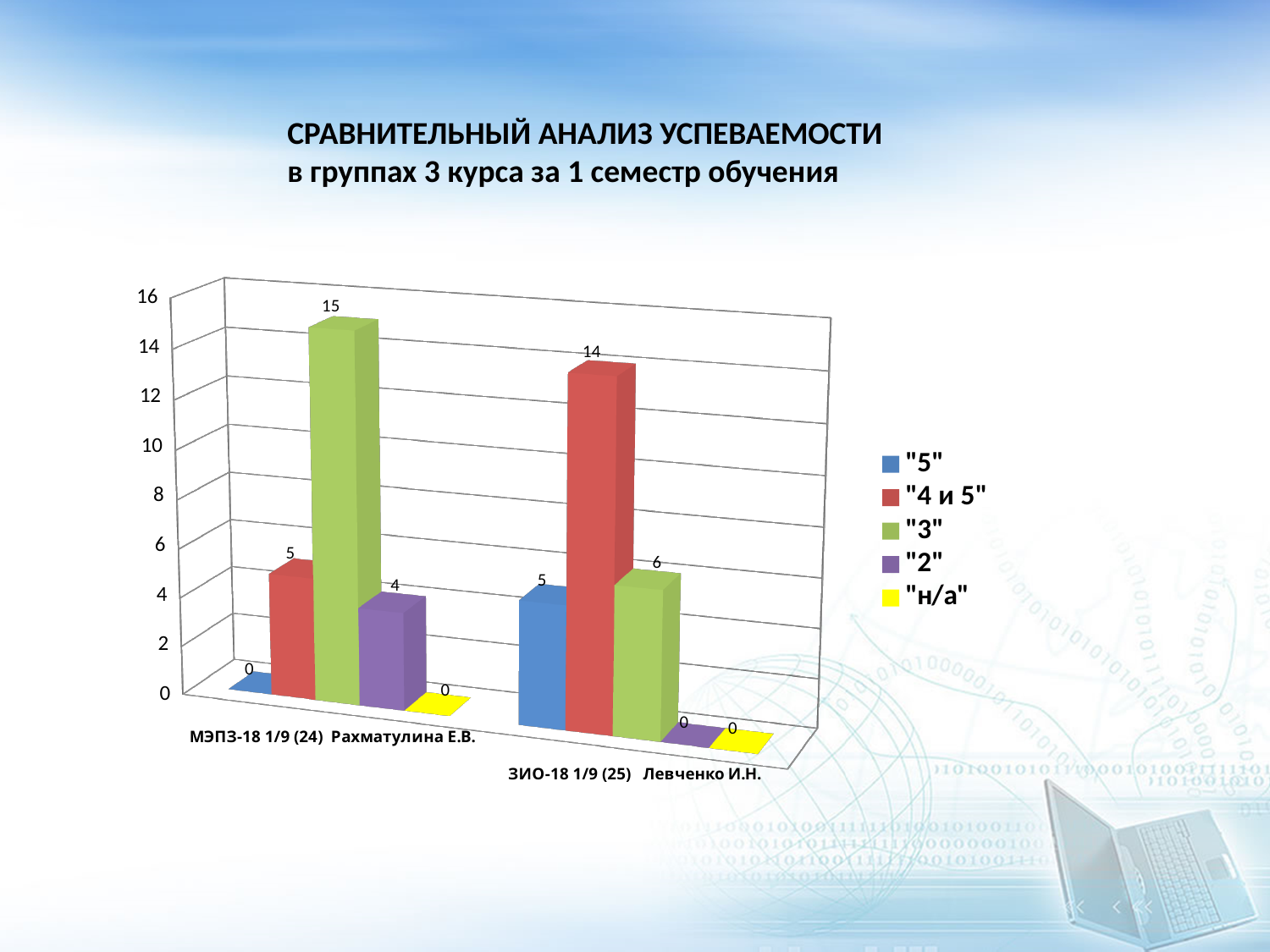
What colour represents the "н/а" series in the legend? yellow How many groups (categories) are shown on the x axis? 2 What is the difference between the "3" values for МЭПЗ-18 1/9 (24) and ЗИО-18 1/9 (25)? 9 What is the value of "2" for МЭПЗ-18 1/9 (24) Рахматулина Е.В.? 4 What type of chart is shown on the slide? bar chart What is the value of "5" for ЗИО-18 1/9 (25) Левченко И.Н.? 5 Which group has the larger value for "5": МЭПЗ-18 1/9 (24) or ЗИО-18 1/9 (25)? ЗИО-18 1/9 (25) Which series has the highest value for МЭПЗ-18 1/9 (24) Рахматулина Е.В.? "3" What is the value of "4 и 5" for ЗИО-18 1/9 (25) Левченко И.Н.? 14 How many series does the legend list? 5 What is the value of "3" for МЭПЗ-18 1/9 (24) Рахматулина Е.В.? 15 Which series has the highest value for ЗИО-18 1/9 (25) Левченко И.Н.? "4 и 5"